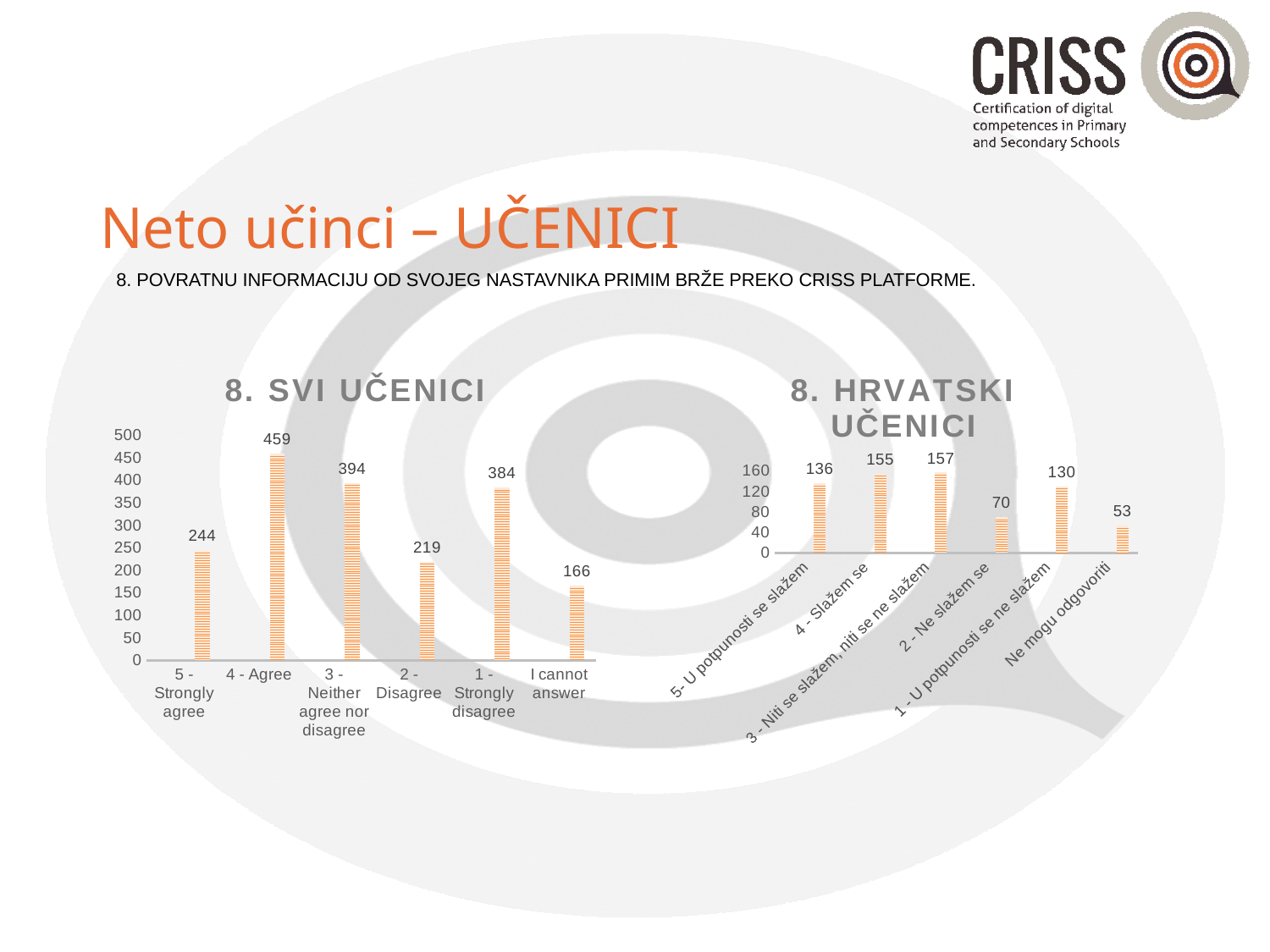
How many categories are shown in the chart titled "8. SVI UČENICI"? 6 In the chart titled "8. SVI UČENICI", what is the value for "4 - Agree"? 459 In the chart titled "8. HRVATSKI UČENICI", which category has the lowest value? Ne mogu odgovoriti In the chart titled "8. HRVATSKI UČENICI", what is the difference between the values for "1 - U potpunosti se ne slažem" and "Ne mogu odgovoriti"? 77 In the chart titled "8. SVI UČENICI", which is larger: the value for "3 - Neither agree nor disagree" or the value for "1 - Strongly disagree"? 3 - Neither agree nor disagree In the chart titled "8. SVI UČENICI", which category has the lowest value? I cannot answer In the chart titled "8. HRVATSKI UČENICI", what is the value for "4 - Slažem se"? 155 In the chart titled "8. HRVATSKI UČENICI", what is the value for "2 - Ne slažem se"? 70 In the chart titled "8. SVI UČENICI", what is the value for "I cannot answer"? 166 In the chart titled "8. SVI UČENICI", what is the difference between the values for "4 - Agree" and "5 - Strongly agree"? 215 In the chart titled "8. SVI UČENICI", which category has the highest value? 4 - Agree What type of chart is the chart titled "8. HRVATSKI UČENICI"? Bar chart